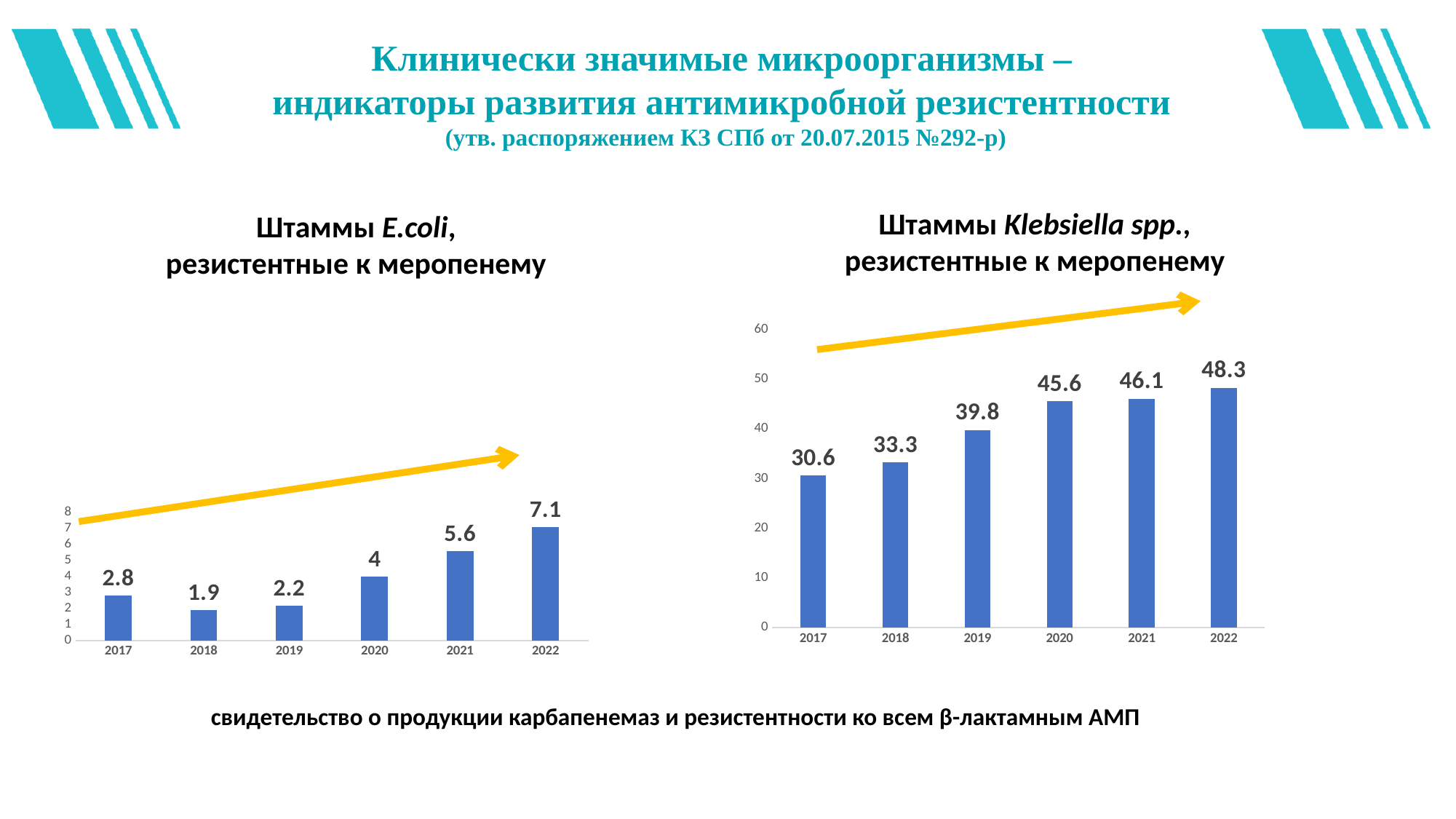
What kind of chart is the right chart (Klebsiella spp. strains resistant to meropenem)? bar chart In the right chart (Klebsiella spp. strains resistant to meropenem), what is the value for 2022? 48.3 In the left chart (E. coli strains resistant to meropenem), what is the value for 2017? 2.8 In the left chart (E. coli strains resistant to meropenem), which year has the lowest value? 2018 In the left chart (E. coli strains resistant to meropenem), how many years are shown on the x axis? 6 In the right chart (Klebsiella spp. strains resistant to meropenem), what is the value for 2019? 39.8 In the right chart (Klebsiella spp. strains resistant to meropenem), do the values generally rise or fall from 2017 to 2022? rise In the right chart (Klebsiella spp. strains resistant to meropenem), what is the difference between the 2022 and 2017 values? 17.7 In the right chart (Klebsiella spp. strains resistant to meropenem), which year has the lowest value? 2017 In the left chart (E. coli strains resistant to meropenem), what is the value for 2020? 4 In the left chart (E. coli strains resistant to meropenem), which year has the highest value? 2022 In the left chart (E. coli strains resistant to meropenem), what is the difference between the 2022 and 2021 values? 1.5